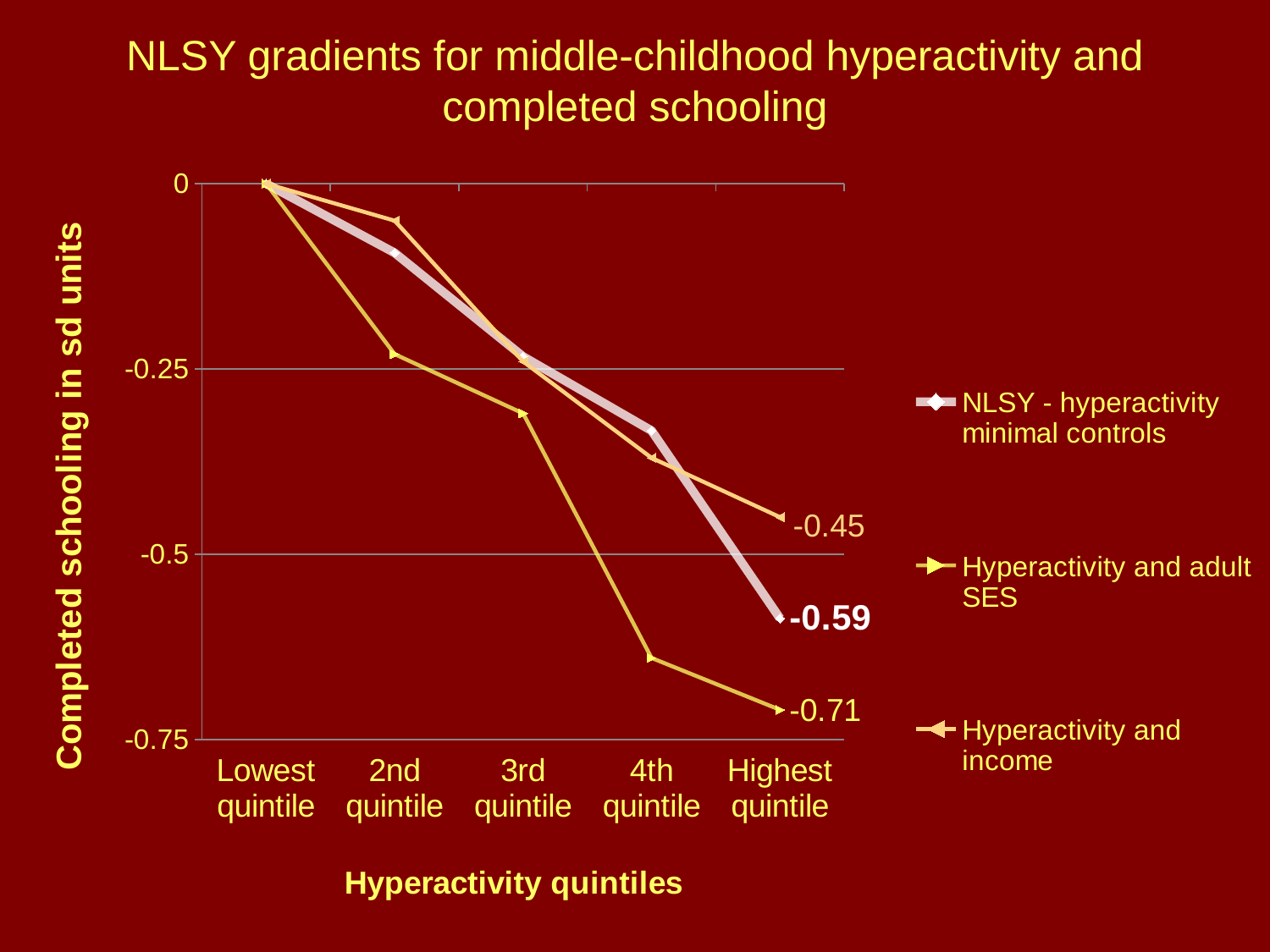
Is the value of the NLSY - hyperactivity minimal controls series at the 2nd quintile greater or less than -0.25? greater How many hyperactivity quintiles are shown on the x axis? 5 What kind of chart is shown on the slide? line chart What is the difference between the -0.45 and -0.71 values labelled at the Highest quintile? 0.26 What is the highest value labelled at the Highest quintile? -0.45 What is the difference between the -0.45 and -0.59 values labelled at the Highest quintile? 0.14 What is the lowest value labelled at the Highest quintile? -0.71 Is the value of the NLSY - hyperactivity minimal controls series at the 4th quintile greater or less than -0.25? less How many series does the legend list? 3 What is the title of the x axis? Hyperactivity quintiles What is the value of the NLSY - hyperactivity minimal controls series at the Highest quintile? -0.59 Do the values rise or fall from the Lowest quintile to the Highest quintile? fall